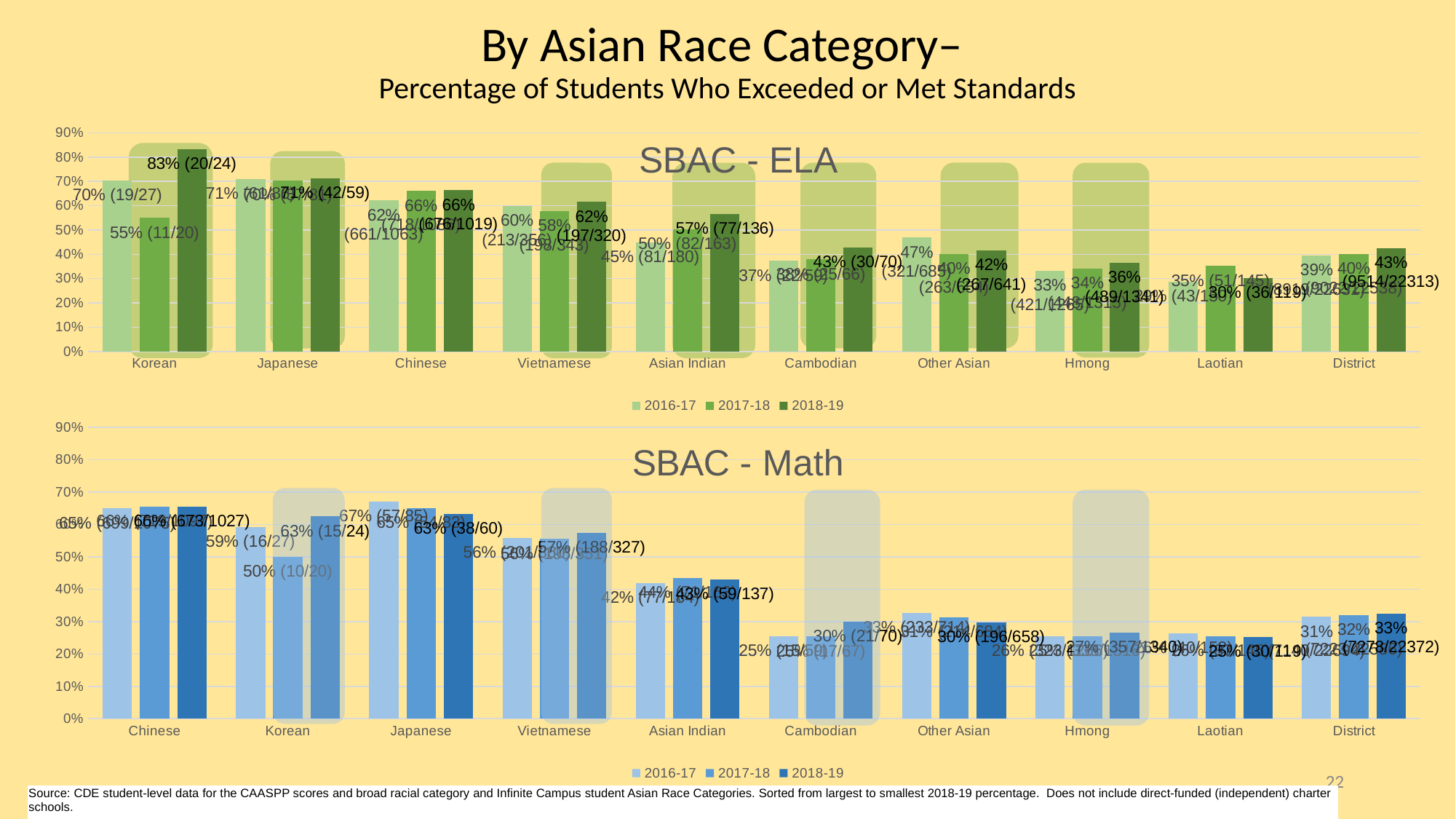
In the SBAC - ELA chart, what is the 2018-19 value for Korean? 83% In the SBAC - Math chart, what is the 2018-19 value for Chinese? 65% In the SBAC - ELA chart, what is the 2018-19 value for Laotian? 30% In the SBAC - ELA chart, which category has the highest 2018-19 value? Korean In the SBAC - Math chart, what is the 2018-19 value for District? 33% In the SBAC - ELA chart, what is the difference between the 2018-19 values for Korean and Japanese? 12 percentage points In the SBAC - Math chart, which category has the lowest 2018-19 value? Laotian In the SBAC - Math chart, what is the 2017-18 value for Korean? 50% How many series does the legend of the SBAC - ELA chart list? 3 In the SBAC - ELA chart, what is the 2017-18 value for Korean? 55% How many categories are shown on the x axis of the SBAC - Math chart? 10 In the SBAC - Math chart, is the 2018-19 value for Vietnamese larger or smaller than the 2018-19 value for Asian Indian? larger